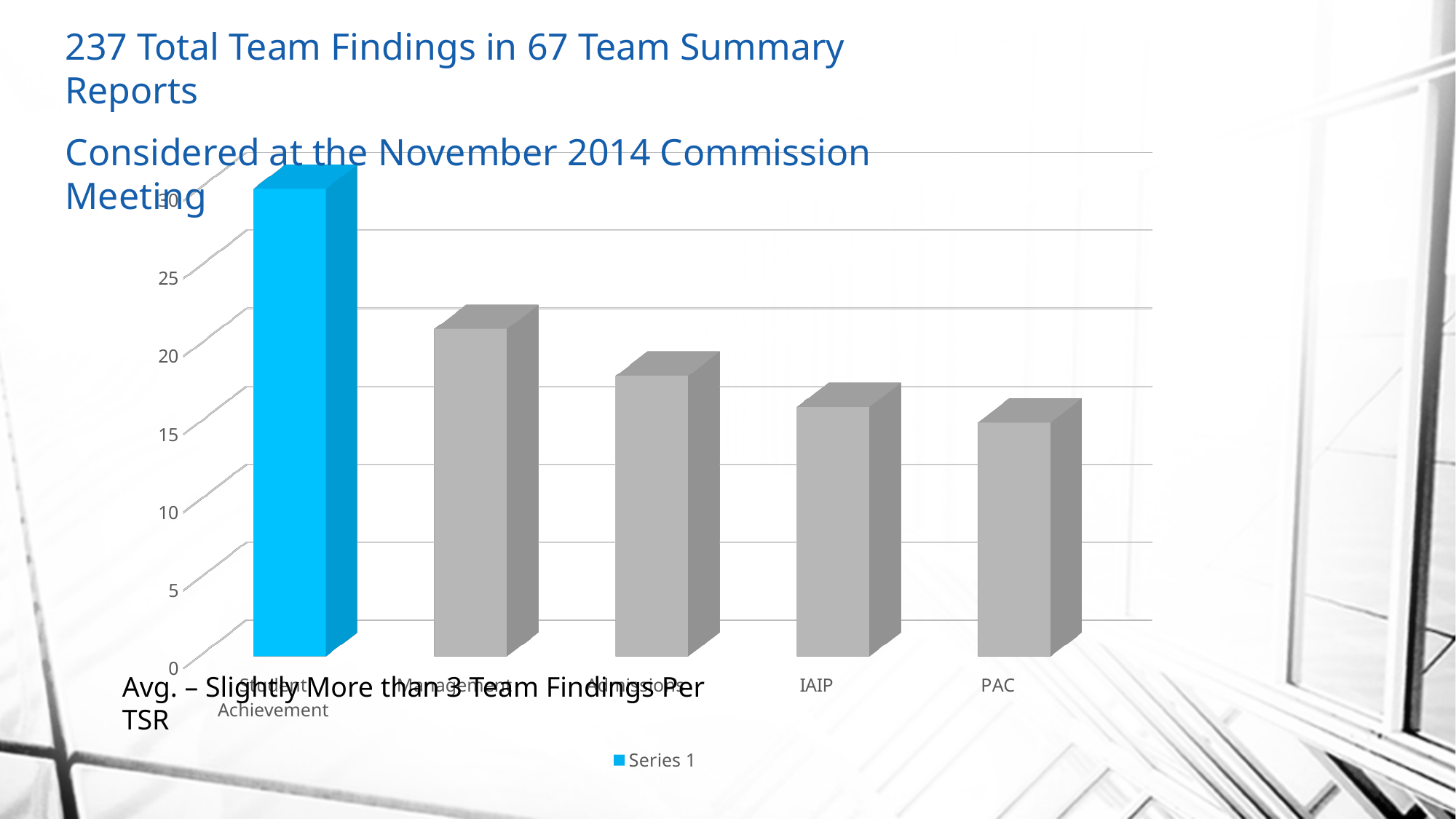
Which category has the lowest value in the chart? PAC Is the value for Admissions greater or less than 20? less How many series does the chart legend list? 1 How many categories are plotted in the chart? 5 Which is larger, the value for Management or the value for Admissions? Management Is the value for Student Achievement greater or less than 25? greater Is the value for IAIP greater or less than 20? less Which category has the highest value in the chart? Student Achievement What is the name of the series shown in the chart legend? Series 1 Do the values rise or fall moving from left to right along the x axis? fall What kind of chart is shown on the slide? bar chart